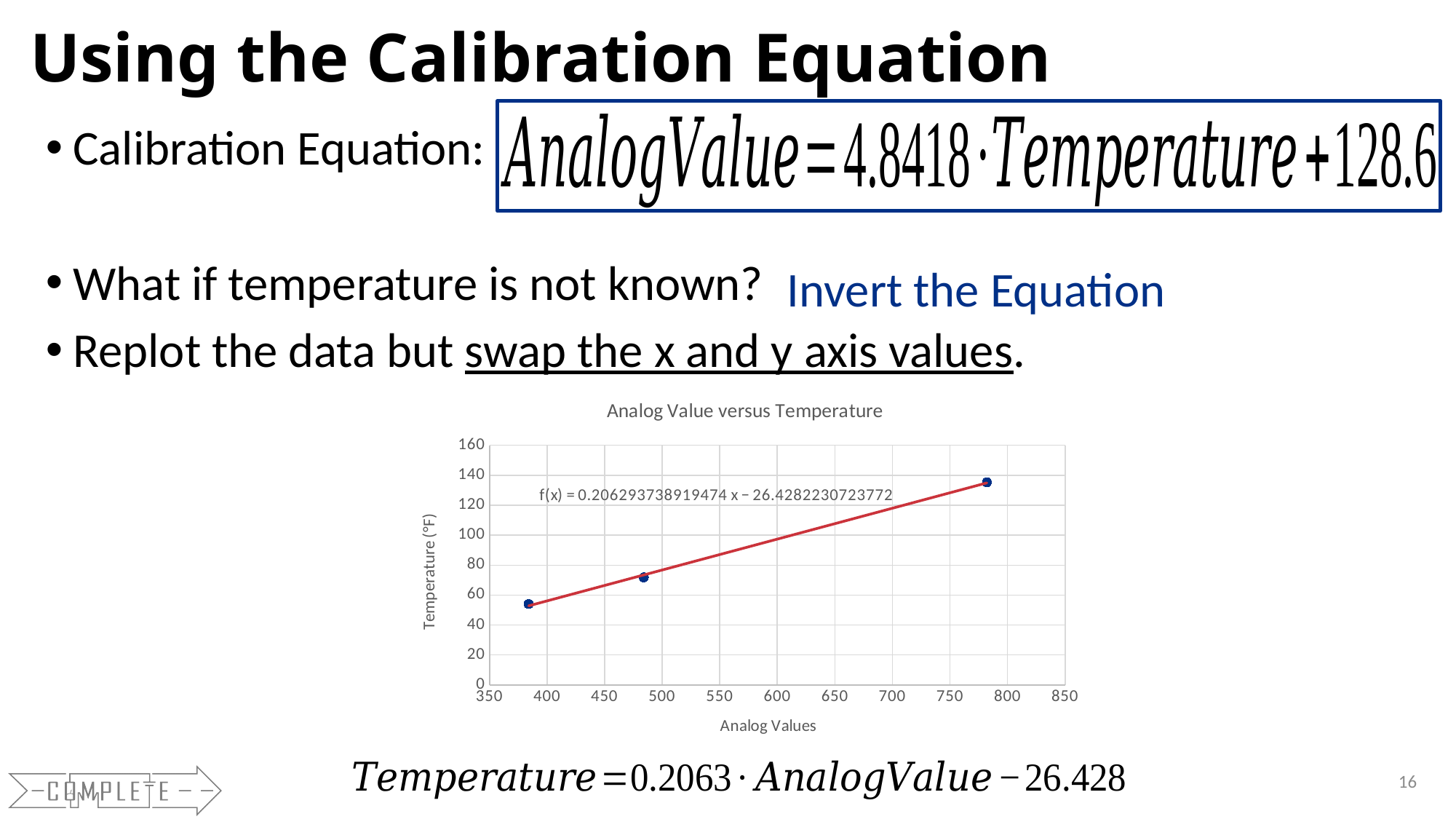
Do the temperature values rise or fall as the analog value increases along the x axis? rise What is the title of the chart? Analog Value versus Temperature Is the temperature for the rightmost data point greater or less than 120? greater Is the analog value of the leftmost data point greater or less than 400? less What kind of chart is shown on the slide? scatter plot What is the slope of the trendline equation f(x) printed on the chart? 0.206293738919474 How many data points are plotted on the chart? 3 Is the temperature for the middle data point greater or less than 80? less What is the label of the x axis of the chart? Analog Values Which data point has the highest temperature: the one with the smallest analog value or the one with the largest analog value? the one with the largest analog value